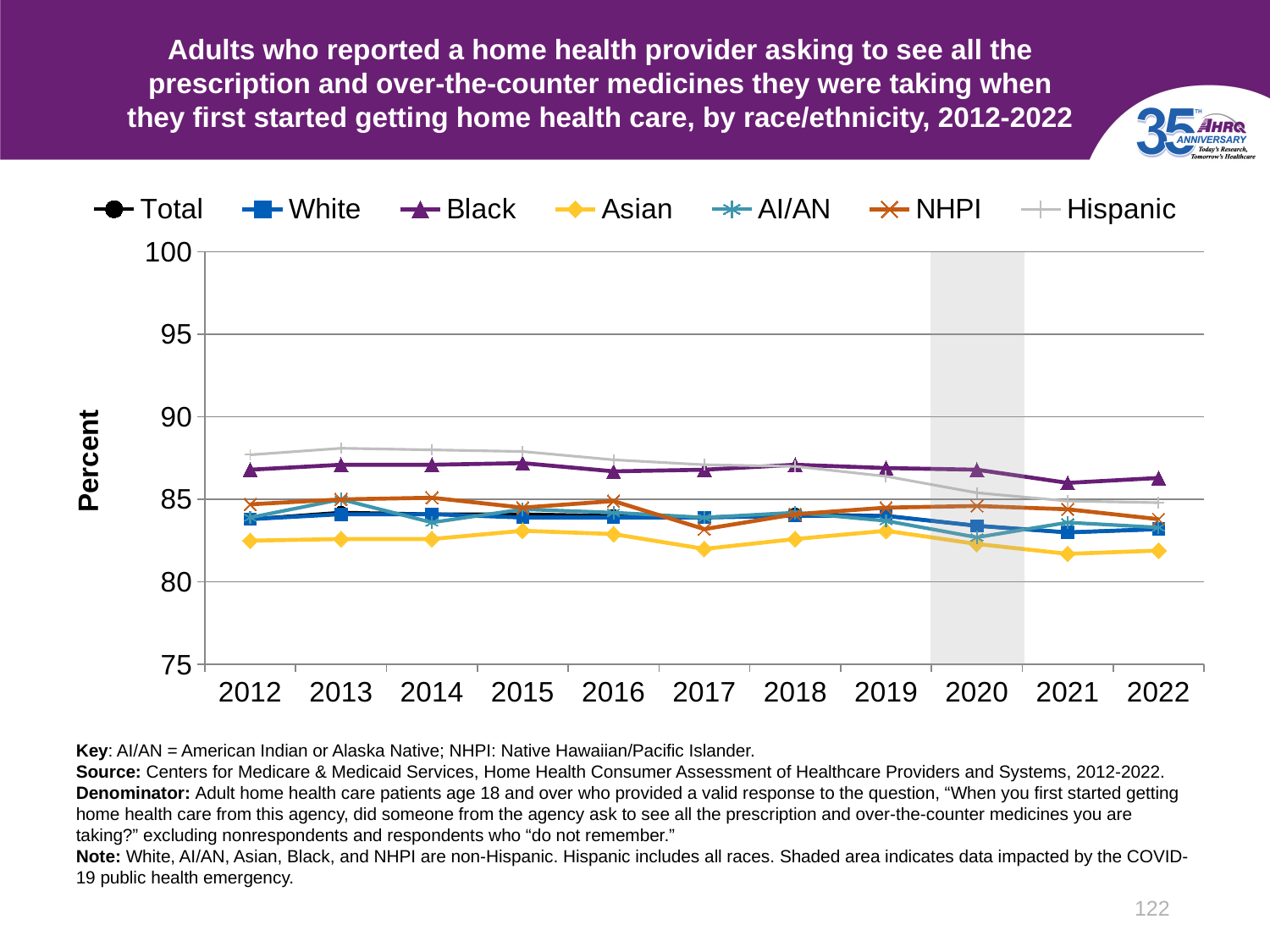
Which race/ethnicity group has the lowest value in 2022? Asian Does the Hispanic line rise or fall from 2013 to 2022? fall In 2016, which is larger, the value for Black or the value for Asian? Black What is the label on the y axis? Percent Is the value for Asian in 2012 greater or less than 85? less How many series does the legend list? 7 Is the value for Black in 2012 greater or less than 85? greater How many years are plotted along the x axis? 11 Is the value for Asian in 2021 greater or less than 80? greater Which race/ethnicity group has the highest value in 2022? Black What kind of chart is shown on the slide? line chart